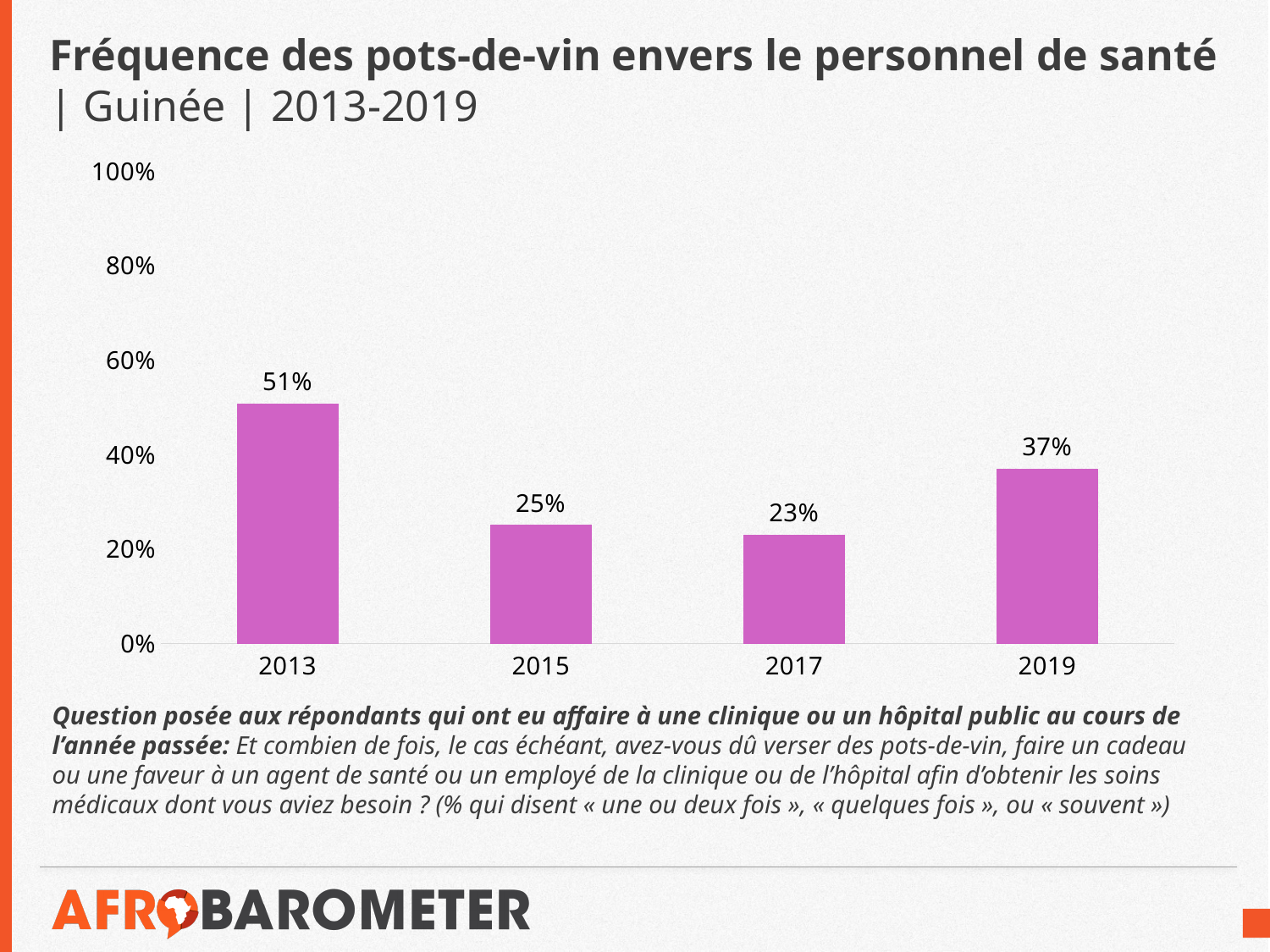
What is the value for 2013? 51% What is the value for 2019? 37% Which is larger, the value for 2015 or the value for 2019? 2019 What is the value for 2017? 23% How many years are shown on the x axis? 4 Does the value rise or fall from 2017 to 2019? Rise What kind of chart is shown on the slide? Bar chart What is the value for 2015? 25% What is the difference between the values for 2013 and 2019? 14% Which year has the highest value? 2013 Which year has the lowest value? 2017 Is the value for 2013 greater or less than 40%? greater